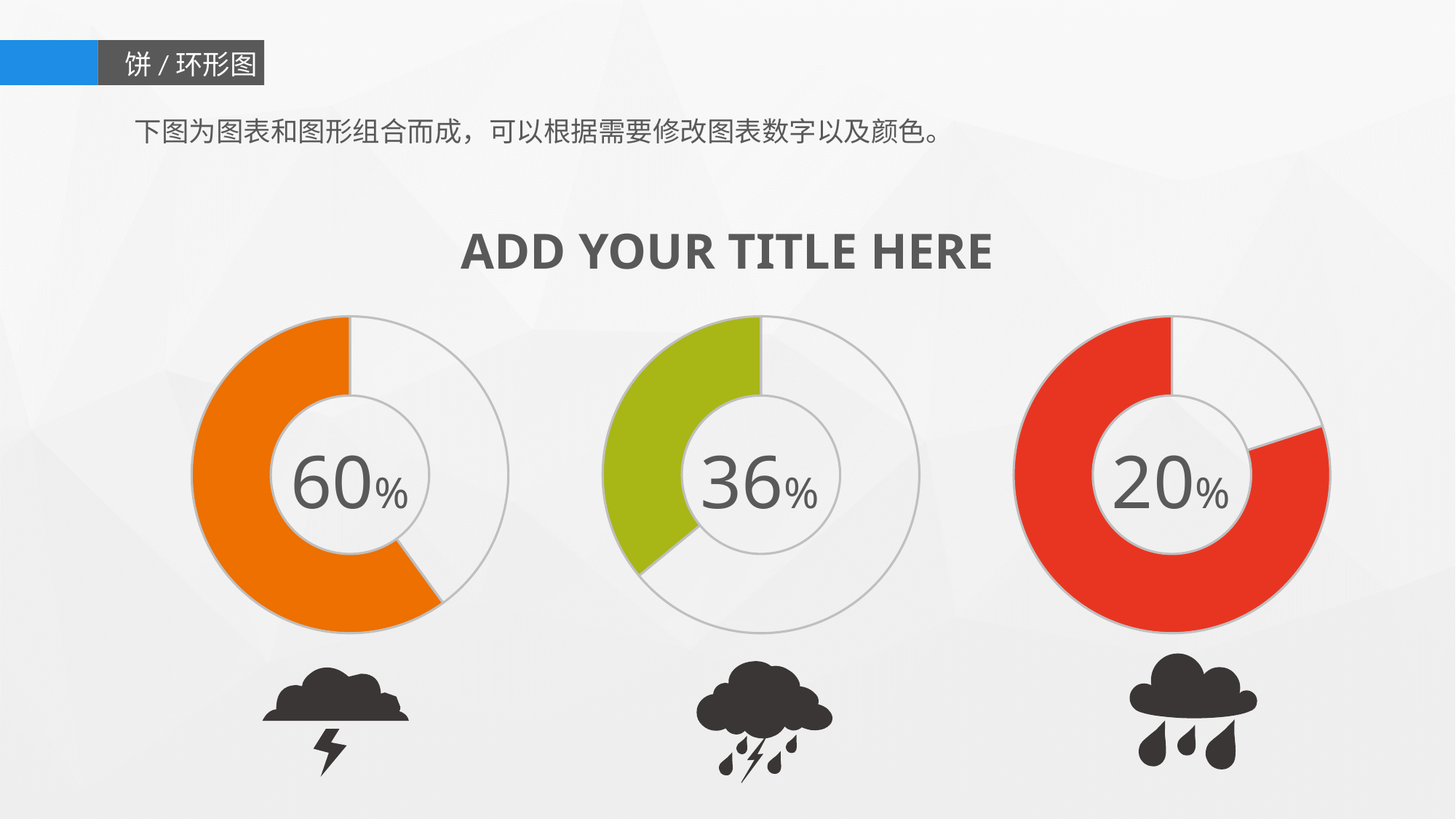
What is the difference between the percentage in the left (orange) chart and the percentage in the middle (green) chart? 24% Which of the three donut charts shows the highest percentage? The left (orange) chart, 60% What kind of chart is used for the three figures on the slide? Donut (ring) chart What colour is the filled ring of the middle donut chart? Green What percentage is shown in the centre of the middle (green) donut chart? 36% What is the title printed above the three donut charts? ADD YOUR TITLE HERE Which of the three donut charts shows the lowest percentage? The right (red) chart, 20% What is the difference between the percentage in the middle (green) chart and the percentage in the right (red) chart? 16% Which is larger, the percentage in the left (orange) chart or the percentage in the middle (green) chart? The left (orange) chart What percentage is shown in the centre of the left (orange) donut chart? 60% What percentage is shown in the centre of the right (red) donut chart? 20% How many donut charts are shown on the slide? 3